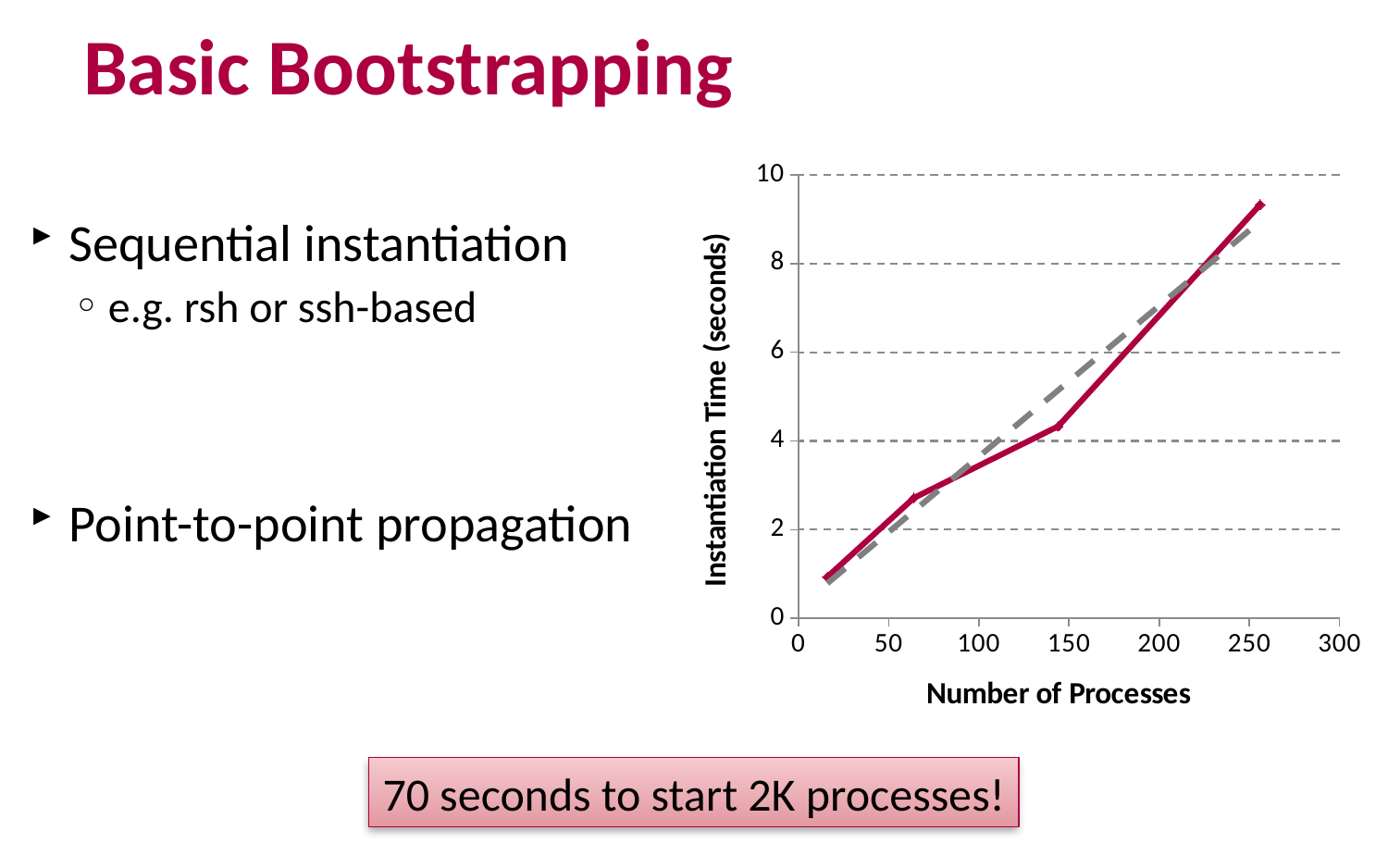
Is the instantiation time at around 150 processes greater or less than 6 seconds? less How many data points are marked on the solid line? 4 What is the title of the x axis of the chart? Number of Processes What is the title of the y axis of the chart? Instantiation Time (seconds) Which data point has the highest instantiation time, the leftmost or the rightmost? the rightmost Is the instantiation time at the rightmost data point (around 250 processes) greater or less than 8 seconds? greater Is the instantiation time at around 150 processes greater or less than 4 seconds? greater What kind of chart is shown on the slide? line chart Does the instantiation time rise or fall as the number of processes increases? rise What is the maximum value shown on the y axis of the chart? 10